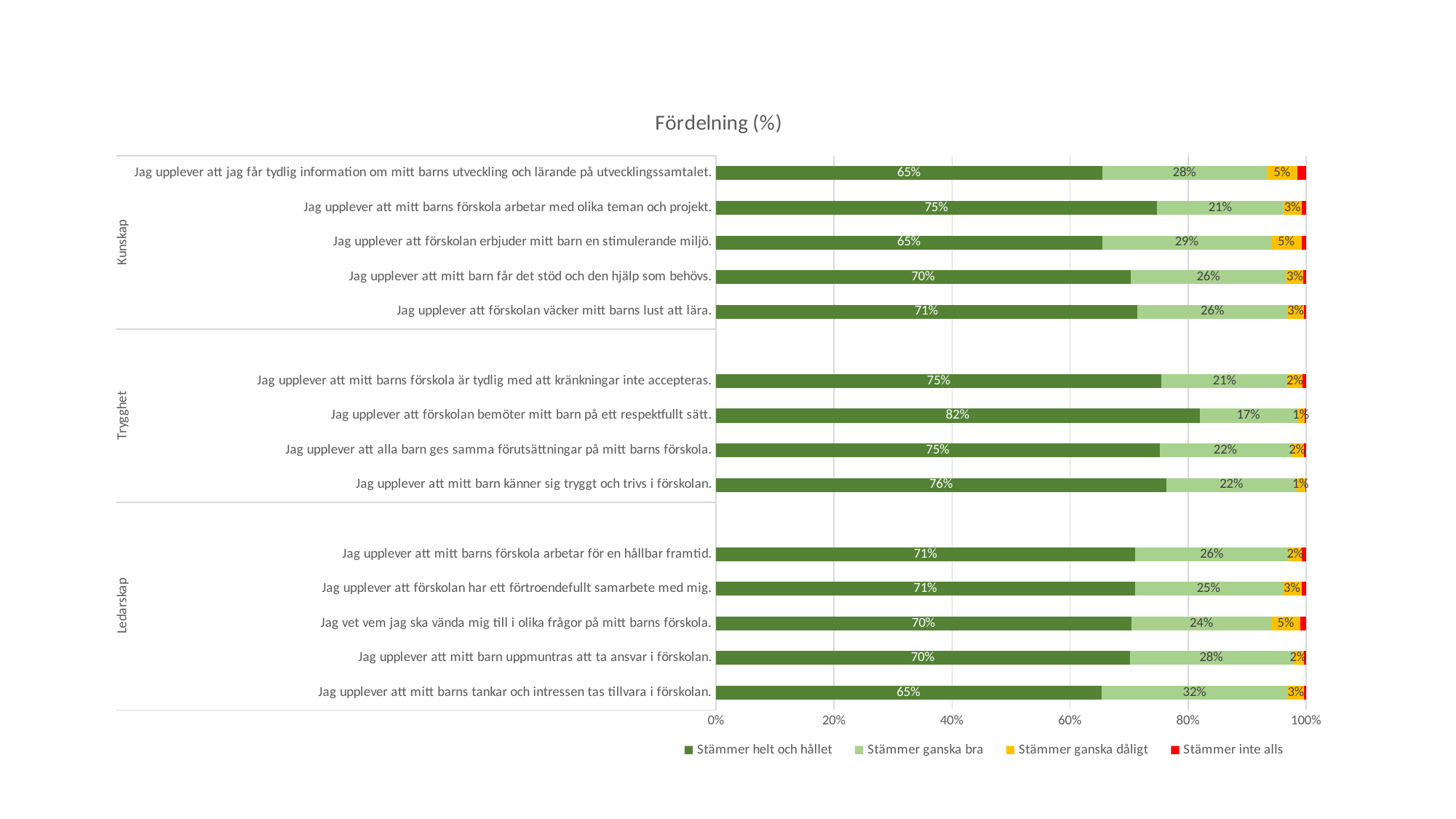
What is the chart's title? Fördelning (%) What kind of chart is shown on the slide? Stacked bar chart What is the 'Stämmer ganska dåligt' value for 'Jag vet vem jag ska vända mig till i olika frågor på mitt barns förskola.'? 5% Which has the larger 'Stämmer helt och hållet' value: 'Jag upplever att mitt barns förskola arbetar med olika teman och projekt.' or 'Jag upplever att mitt barn får det stöd och den hjälp som behövs.'? Jag upplever att mitt barns förskola arbetar med olika teman och projekt. Which statement has the lowest 'Stämmer ganska bra' value? Jag upplever att förskolan bemöter mitt barn på ett respektfullt sätt. How many series does the legend list? 4 Which statement has the highest 'Stämmer helt och hållet' value? Jag upplever att förskolan bemöter mitt barn på ett respektfullt sätt. What is the difference in 'Stämmer helt och hållet' between 'Jag upplever att förskolan bemöter mitt barn på ett respektfullt sätt.' (82%) and 'Jag upplever att förskolan erbjuder mitt barn en stimulerande miljö.' (65%)? 17 percentage points Is the 'Stämmer helt och hållet' value for 'Jag upplever att mitt barn känner sig tryggt och trivs i förskolan.' greater or less than 60%? greater How many statements (bars) are plotted in the chart? 14 What is the 'Stämmer ganska bra' value for 'Jag upplever att mitt barns tankar och intressen tas tillvara i förskolan.'? 32% What is the 'Stämmer helt och hållet' value for 'Jag upplever att förskolan bemöter mitt barn på ett respektfullt sätt.'? 82%